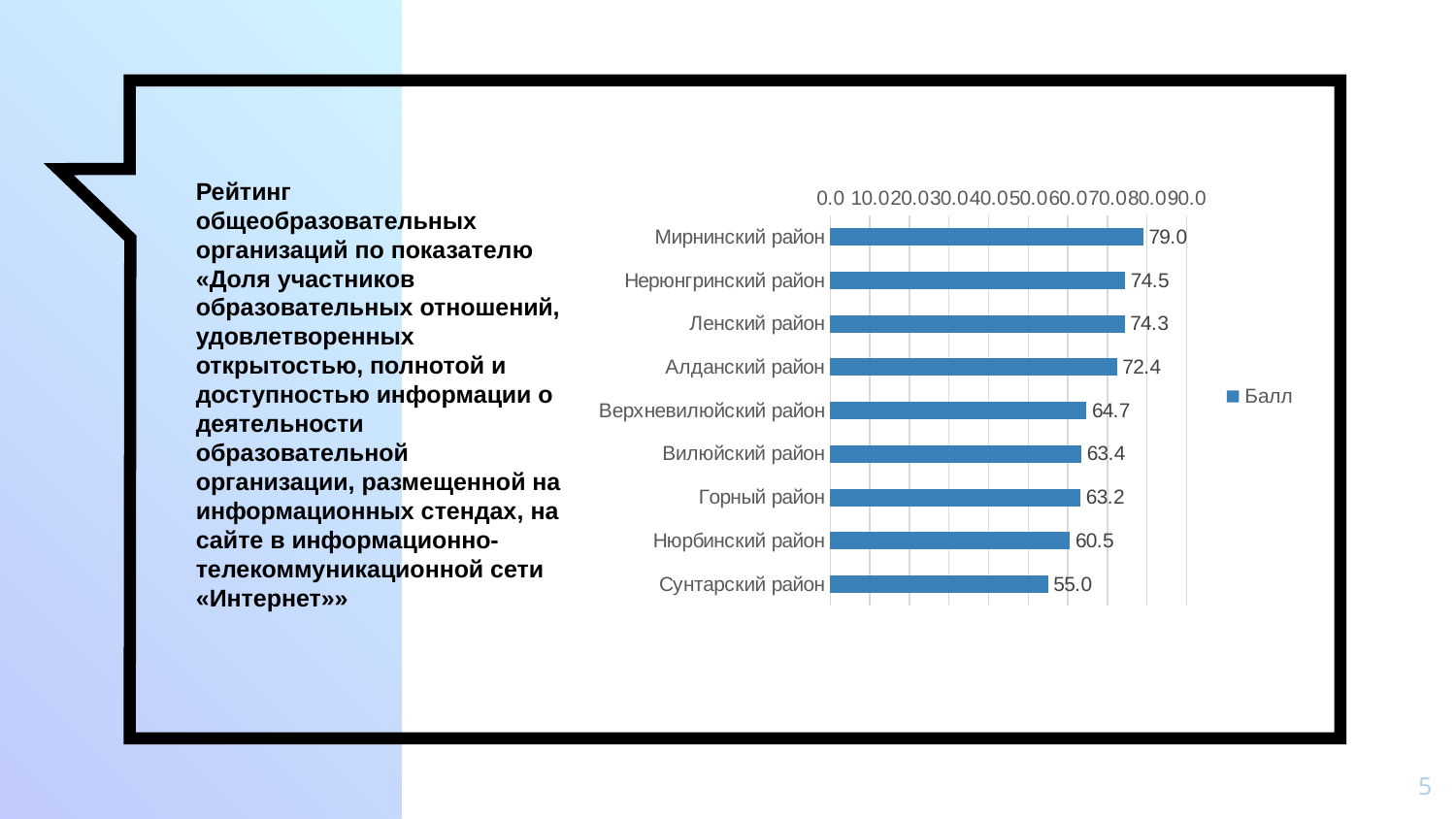
How many districts are shown in the chart? 9 Which is larger, the value for Вилюйский район or the value for Нюрбинский район? Вилюйский район What is the value for Сунтарский район? 55.0 What is the difference between the values for Алданский район and Нюрбинский район? 11.9 What is the value for Мирнинский район? 79.0 What is the value for Верхневилюйский район? 64.7 Is the value for Горный район greater or less than 70.0? less What kind of chart is shown on the slide? bar chart Which district has the highest value? Мирнинский район What is the difference between the values for Мирнинский район and Сунтарский район? 24.0 How many series does the legend list? 1 Which district has the lowest value? Сунтарский район